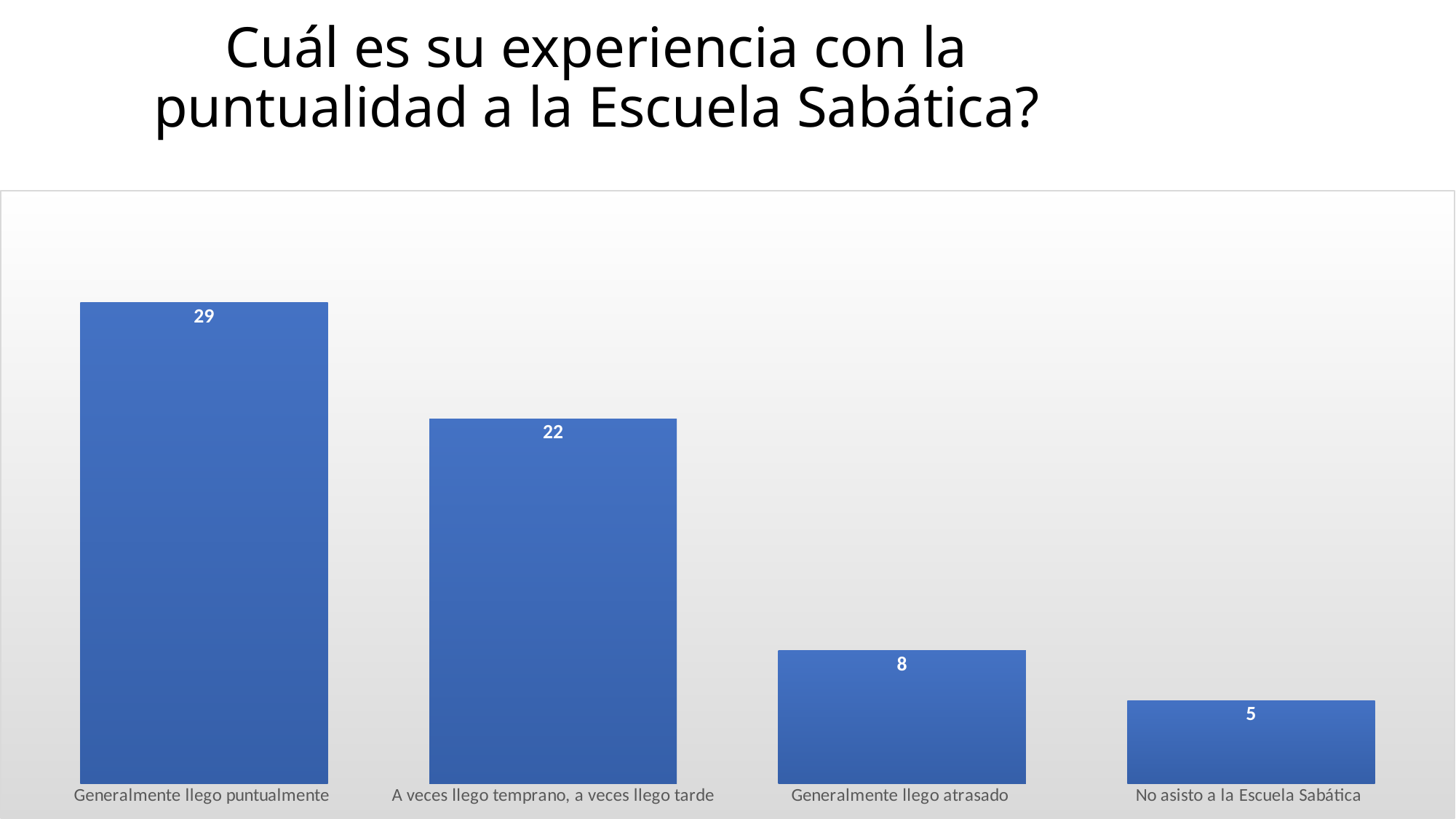
What kind of chart is shown on the slide? Bar chart Which category has the lowest value? No asisto a la Escuela Sabática Which category has the highest value? Generalmente llego puntualmente What is the value for "Generalmente llego atrasado"? 8 How many categories are shown in the chart? 4 What is the difference between the values for "Generalmente llego puntualmente" and "A veces llego temprano, a veces llego tarde"? 7 What is the value for "A veces llego temprano, a veces llego tarde"? 22 Which is larger, the value for "A veces llego temprano, a veces llego tarde" or the value for "Generalmente llego atrasado"? A veces llego temprano, a veces llego tarde What is the value for "No asisto a la Escuela Sabática"? 5 What is the difference between the values for "Generalmente llego atrasado" and "No asisto a la Escuela Sabática"? 3 What is the value for "Generalmente llego puntualmente"? 29 Do the values rise or fall from left to right across the categories? Fall